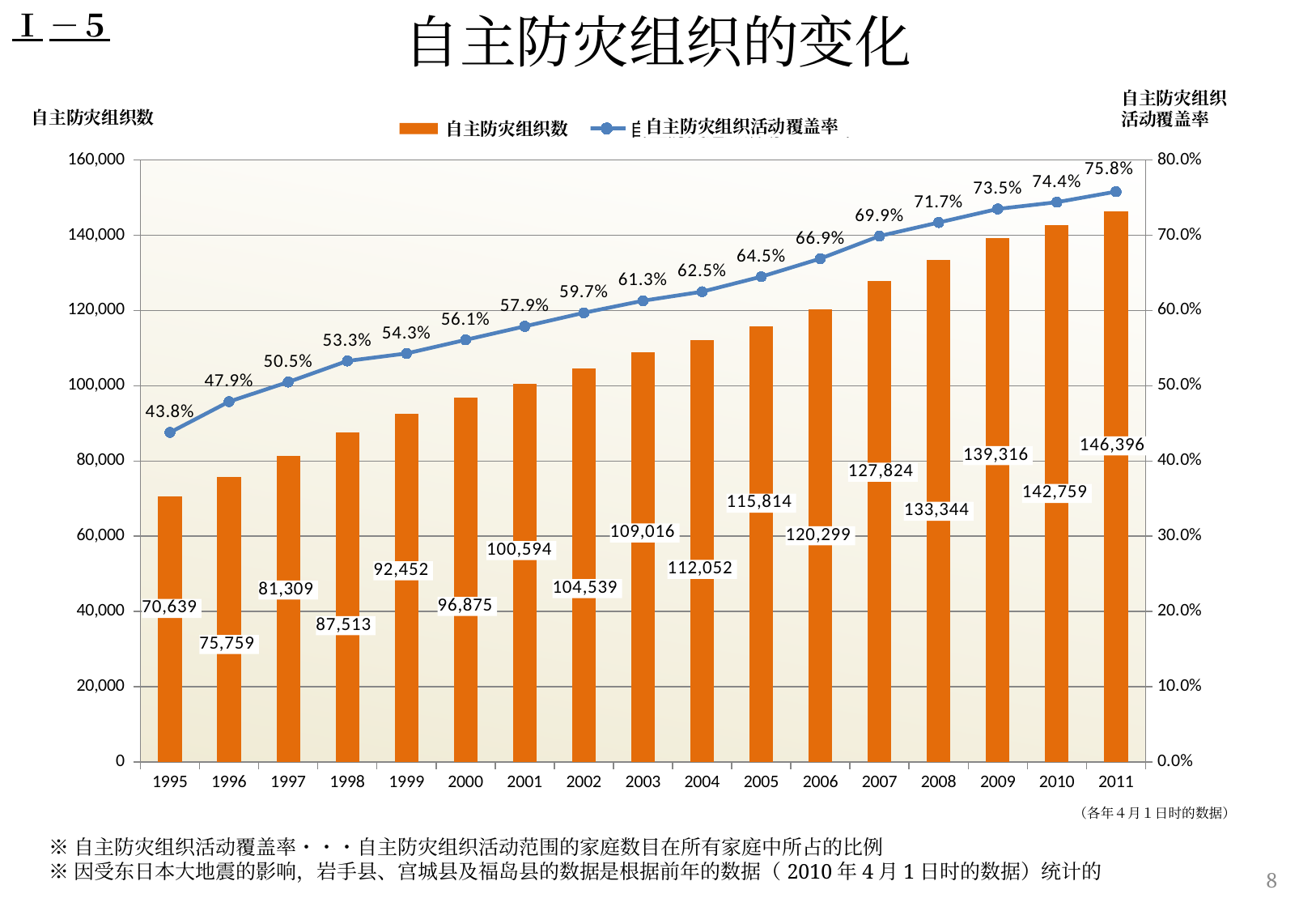
Which year has a larger 自主防灾组织数, 2000 or 2006? 2006 What is the difference in 自主防灾组织数 between 2011 and 1995? 75,757 What is the 自主防灾组织活动覆盖率 for 2007? 69.9% What is the value of 自主防灾组织数 for 2003? 109,016 What is the value of 自主防灾组织数 for 2011? 146,396 What is the 自主防灾组织活动覆盖率 for 1995? 43.8% Which year has the lowest 自主防灾组织数? 1995 How many series does the legend list? 2 How many years are shown on the x axis? 17 What is the difference in 自主防灾组织活动覆盖率 between 2010 and 2009? 0.9% Does the 自主防灾组织活动覆盖率 rise or fall from 1995 to 2011? rise Which year has the highest 自主防灾组织活动覆盖率? 2011